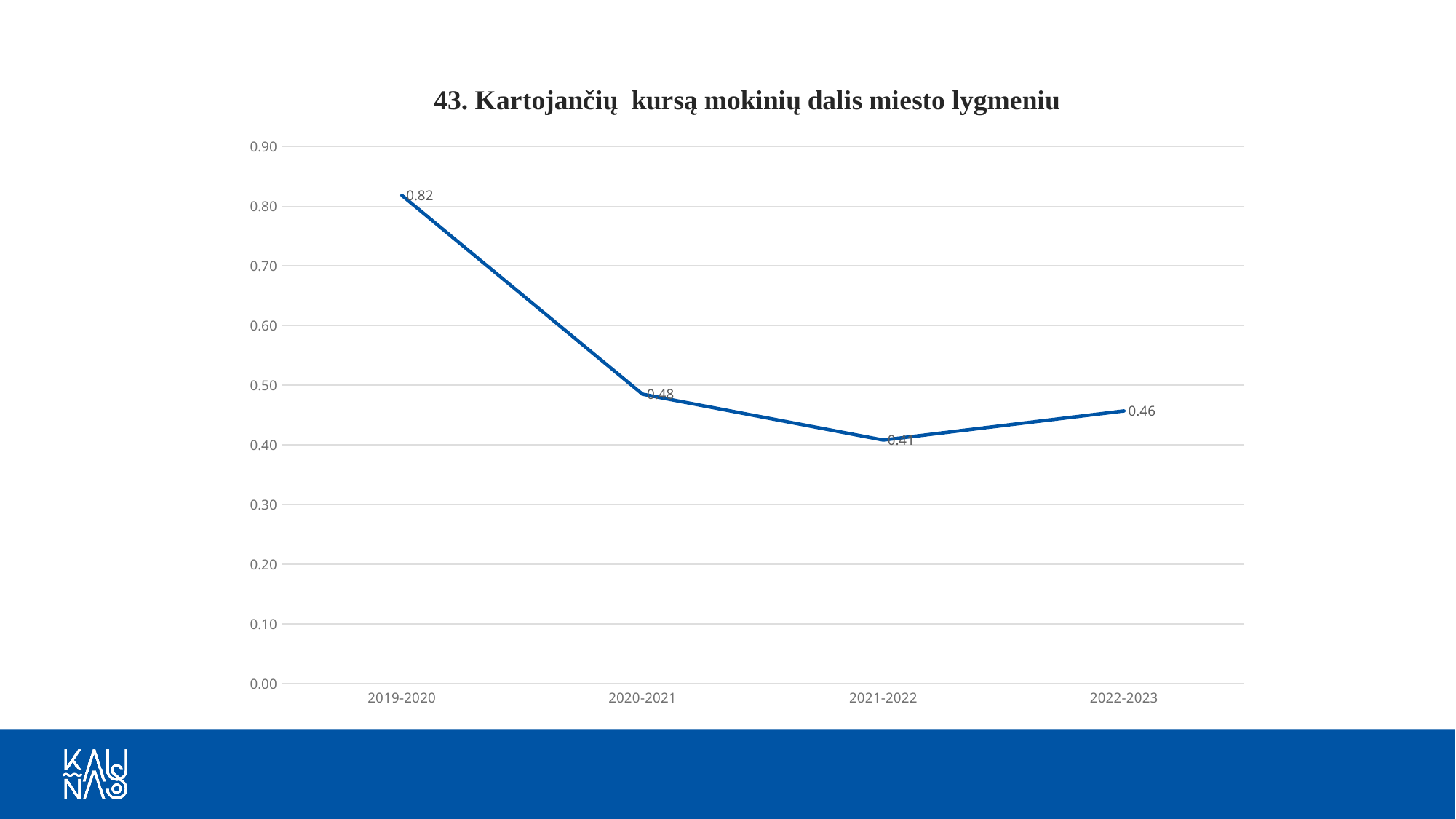
What is the value for 2022-2023? 0.46 What is the value for 2019-2020? 0.82 Which is larger, the value for 2020-2021 or the value for 2022-2023? 2020-2021 What is the value for 2020-2021? 0.48 What is the difference between the values for 2019-2020 and 2020-2021? 0.34 Which school year has the highest value? 2019-2020 What kind of chart is shown on the slide? line chart What is the value for 2021-2022? 0.41 What is the title of the chart? 43. Kartojančių kursą mokinių dalis miesto lygmeniu Is the value for 2019-2020 greater or less than 0.80? greater Which school year has the lowest value? 2021-2022 How many school years are plotted on the chart? 4